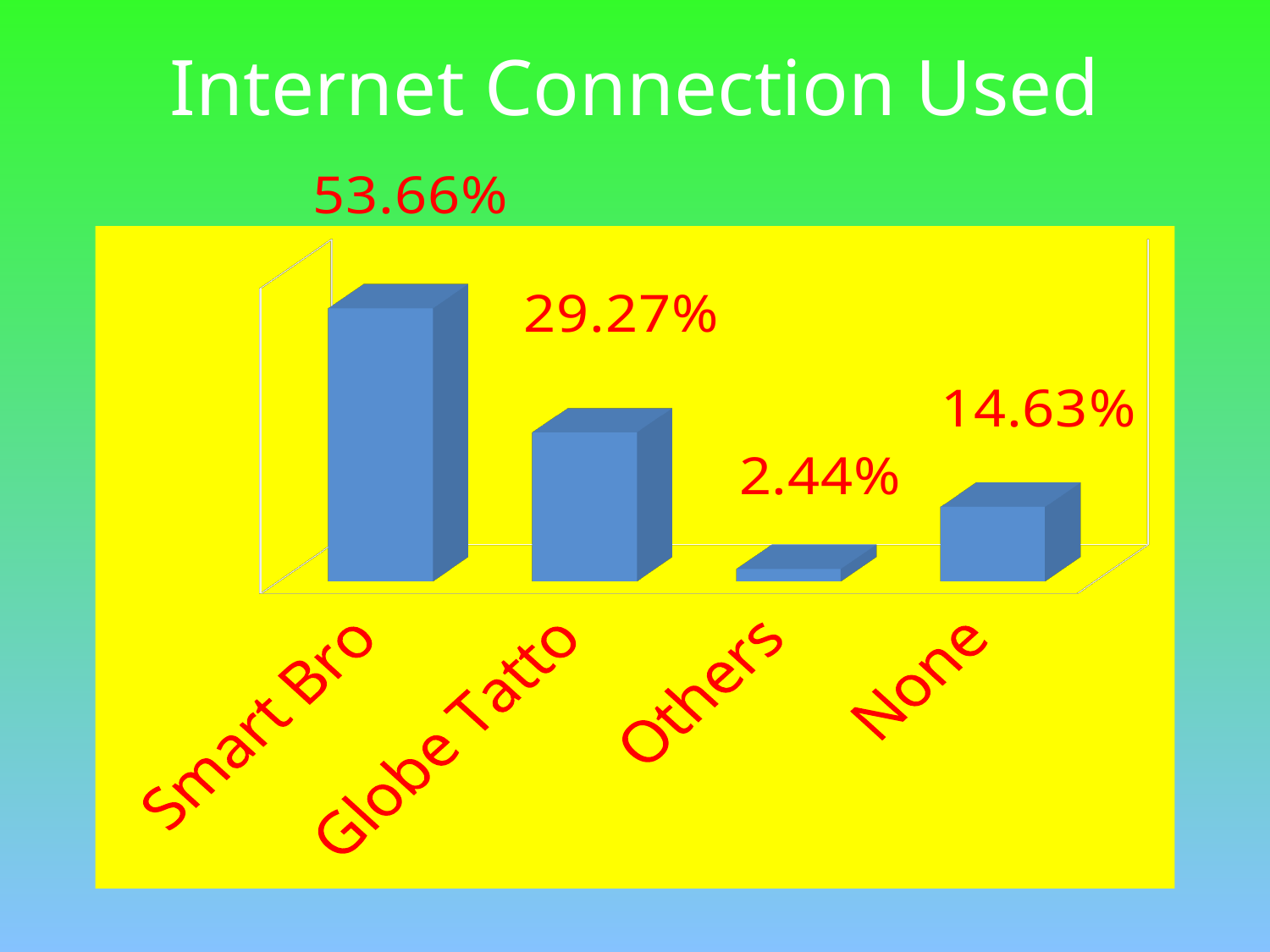
What is the title of the chart? Internet Connection Used Which is larger, the value for Globe Tatto or the value for None? Globe Tatto Which category has the lowest value? Others Which category has the highest value? Smart Bro How many categories are shown in the chart? 4 What kind of chart is shown on the slide? Bar chart What is the value for Globe Tatto? 29.27% What is the value for Smart Bro? 53.66% What is the value for None? 14.63% What is the difference between the values for None and Others? 12.19% What is the difference between the values for Smart Bro and Globe Tatto? 24.39% What is the value for Others? 2.44%